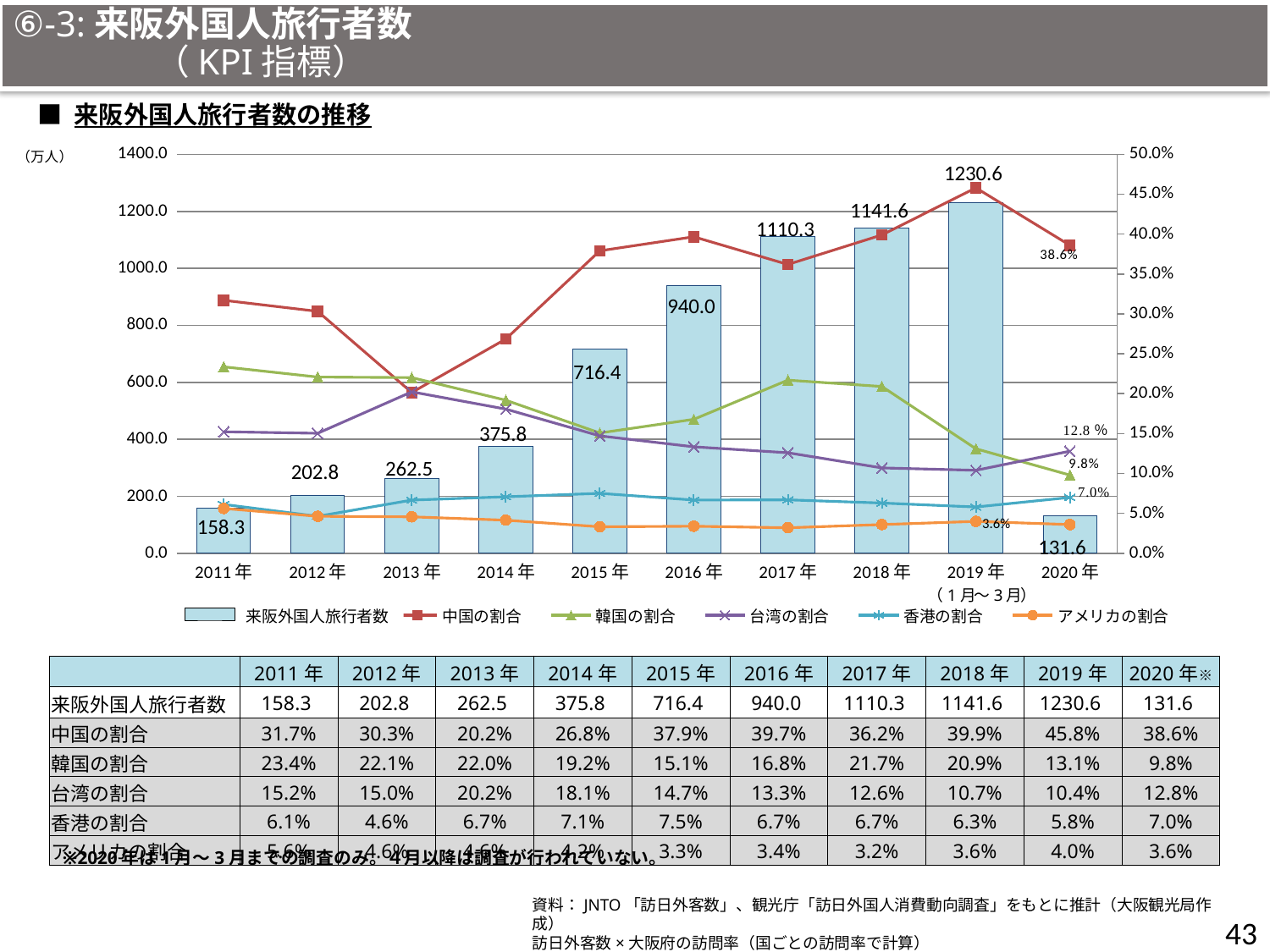
Do the 来阪外国人旅行者数 bars rise or fall from 2011年 to 2019年? rise What is the value of 来阪外国人旅行者数 for 2019年? 1230.6 Which year has the lowest 来阪外国人旅行者数 bar? 2020年 What kind of chart is shown on the slide? Combined bar and line chart What is the value of 来阪外国人旅行者数 for 2011年? 158.3 Which is larger, the 来阪外国人旅行者数 value for 2015年 or for 2014年? 2015年 Which year has the highest 来阪外国人旅行者数 bar? 2019年 Is the 中国の割合 value for 2019年 greater or less than 40.0%? greater What is the 中国の割合 value labeled for 2020年 on the chart? 38.6% How many series does the chart legend list? 6 How many years are shown on the x axis of the chart? 10 What is the difference between the 来阪外国人旅行者数 values for 2018年 and 2017年? 31.3